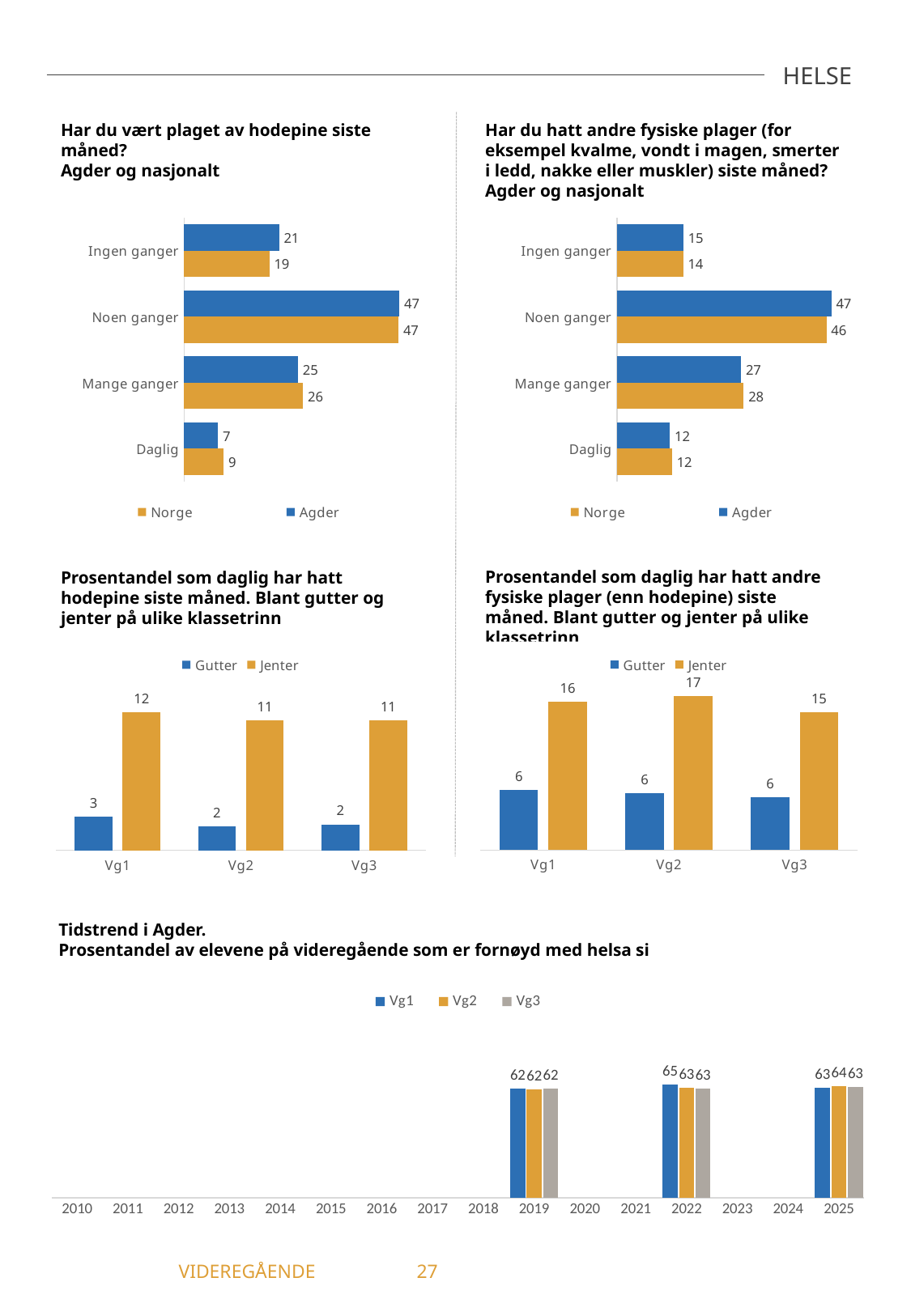
In the middle-right chart 'Prosentandel som daglig har hatt andre fysiske plager', what is the difference between Jenter and Gutter at Vg3? 9 In the bottom chart 'Tidstrend i Agder', what is the value for Vg1 in 2022? 65 In the middle-right chart 'Prosentandel som daglig har hatt andre fysiske plager', which class level has the highest value for Jenter? Vg2 In the top-left chart 'Har du vært plaget av hodepine siste måned?', what is the value for Agder in the 'Noen ganger' category? 47 In the middle-left chart 'Prosentandel som daglig har hatt hodepine siste måned', what is the value for Jenter at Vg1? 12 In the top-right chart 'Har du hatt andre fysiske plager ... siste måned?', how many categories are shown on the axis? 4 In the bottom chart 'Tidstrend i Agder', how many series does the legend list? 3 In the top-left chart 'Har du vært plaget av hodepine siste måned?', what is the difference between the Agder and Norge values for 'Ingen ganger'? 2 In the top-right chart 'Har du hatt andre fysiske plager ... siste måned?', what is the value for Norge in the 'Mange ganger' category? 28 In the top-left chart 'Har du vært plaget av hodepine siste måned?', what is the value for Norge in the 'Daglig' category? 9 In the top-right chart 'Har du hatt andre fysiske plager ... siste måned?', which category has the highest value for Agder? Noen ganger In the middle-left chart 'Prosentandel som daglig har hatt hodepine siste måned', which is larger at Vg2: Gutter or Jenter? Jenter